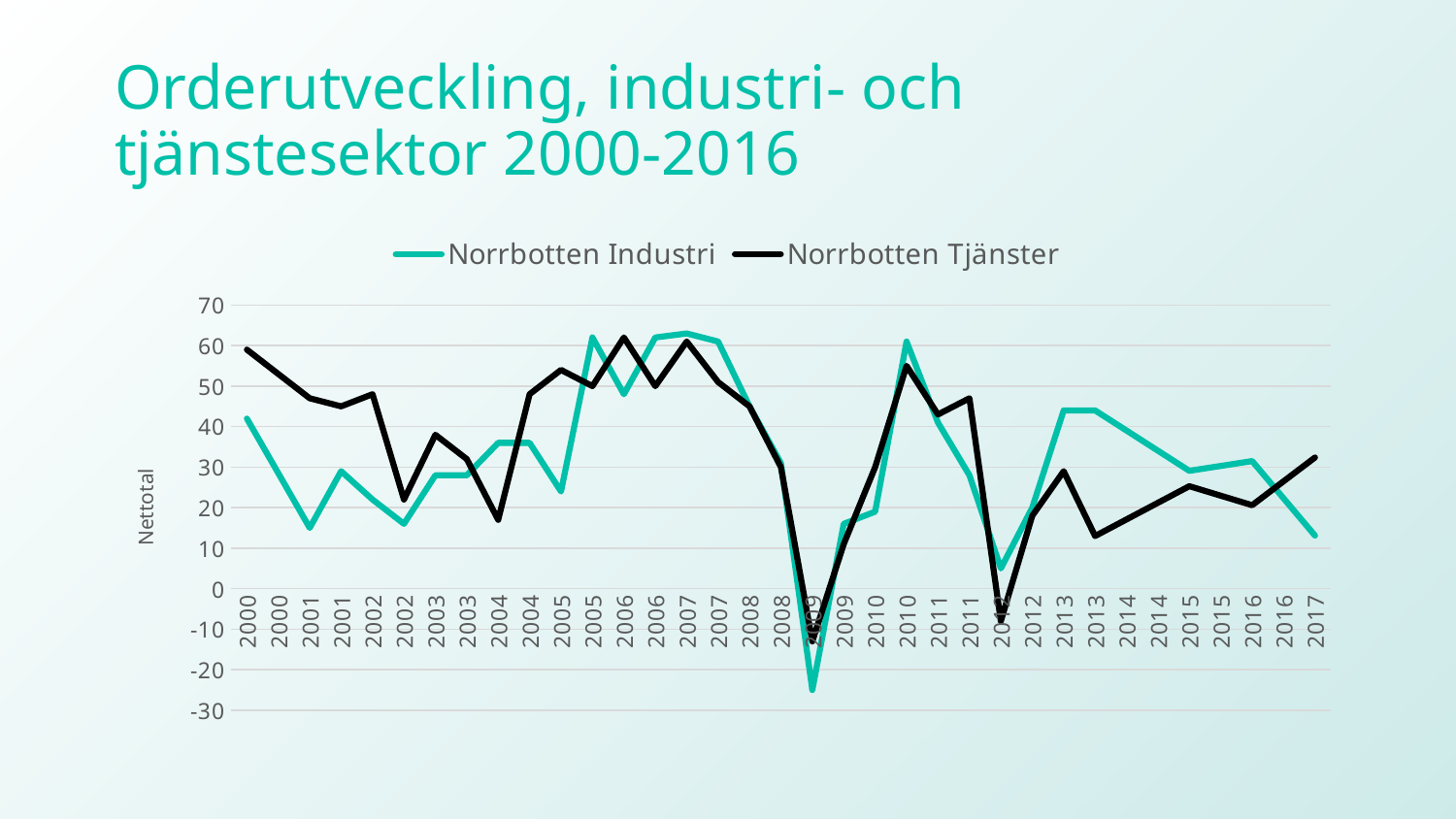
What kind of chart is shown on the slide? line chart In which year does Norrbotten Industri reach its lowest value? 2009 Is the value for Norrbotten Tjänster at the first 2000 point greater or less than 50? greater What are the two series named in the legend? Norrbotten Industri and Norrbotten Tjänster Which series has the higher value at 2017, Norrbotten Industri or Norrbotten Tjänster? Norrbotten Tjänster Does the Norrbotten Industri line rise or fall between the second 2016 point and 2017? fall What is the label on the vertical axis? Nettotal Is the value for Norrbotten Tjänster at 2017 greater or less than 20? greater Is the value for Norrbotten Industri at the first 2000 point greater or less than 30? greater How many series does the legend list? 2